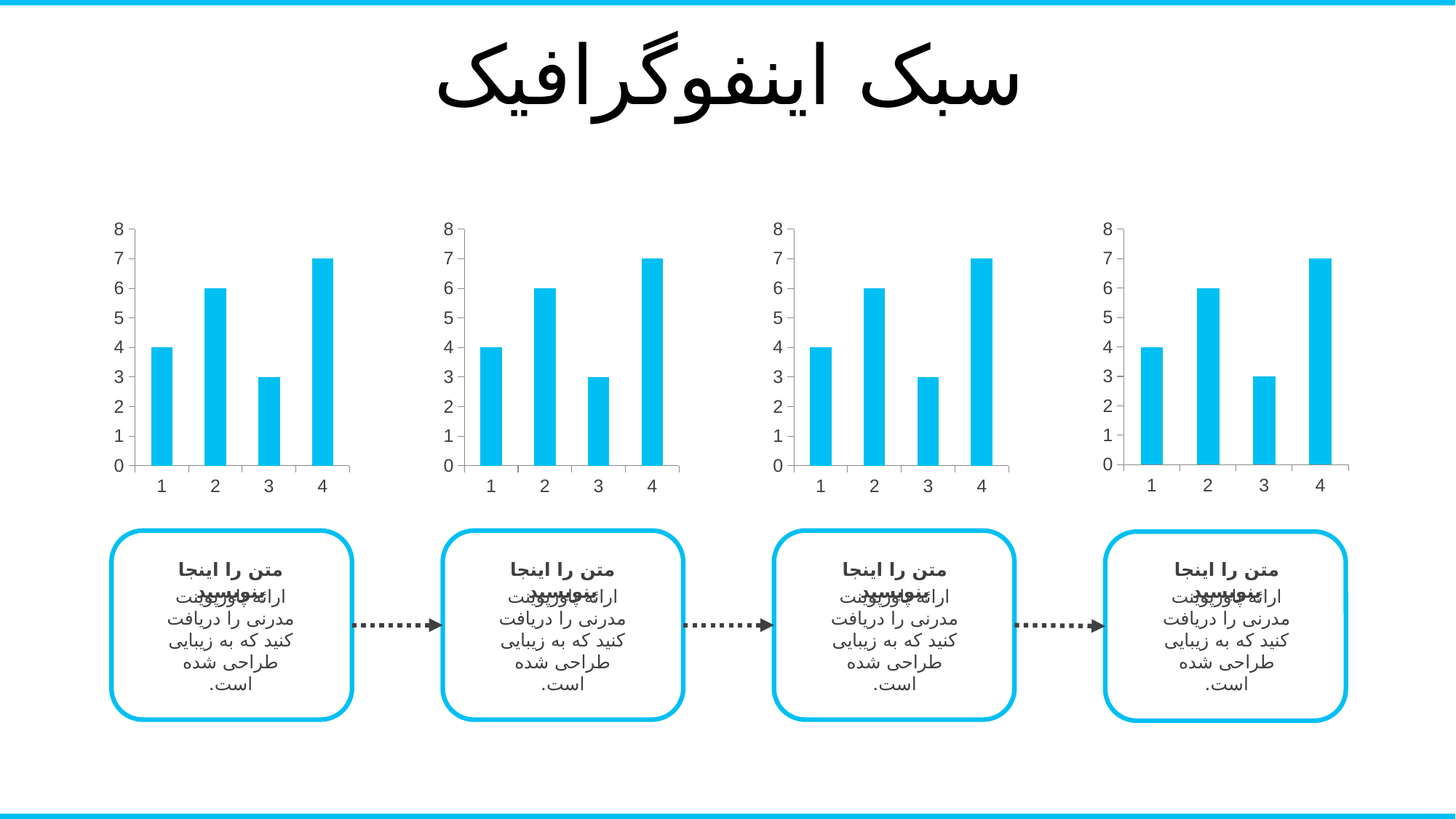
What kind of chart is the rightmost chart? bar chart In the second chart from the left, what is the difference between the values for category 4 and category 3? 4 In the rightmost chart, what is the value for category 3? 3 In the leftmost chart, which category has the lowest value? 3 In the rightmost chart, how many categories are shown on the x axis? 4 In the second chart from the left, what is the value for category 1? 4 In the third chart from the left, what is the value for category 2? 6 In the leftmost chart, what is the value for category 4? 7 In the third chart from the left, which is larger, the value for category 2 or the value for category 1? category 2 How many bar charts are shown on the slide? 4 In the leftmost chart, is the value for category 4 greater or less than 5? greater In the leftmost chart, which category has the highest value? 4